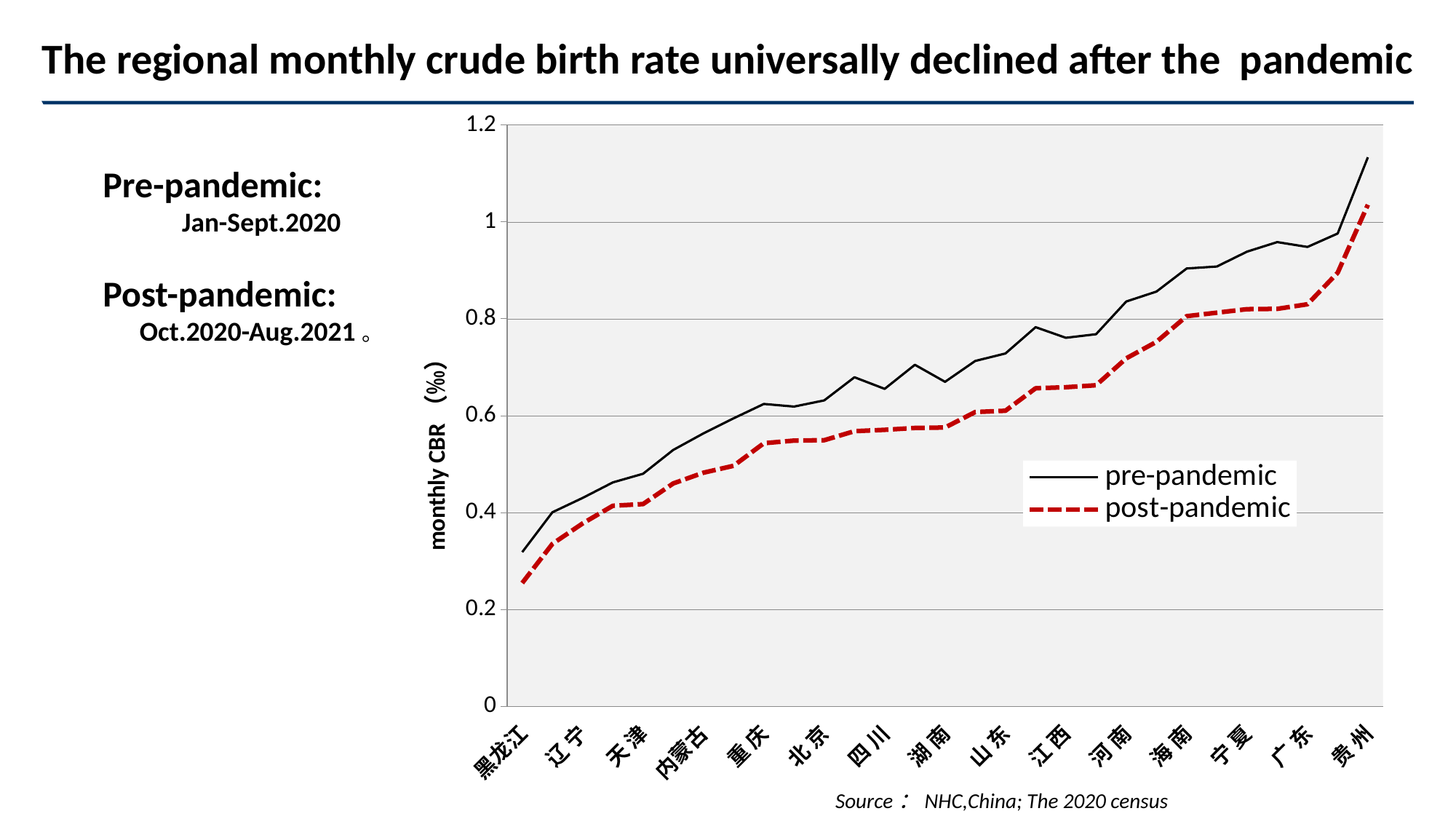
Which region has the lowest post-pandemic monthly CBR? 黑龙江 Is the pre-pandemic value for 贵州 greater or less than 1? greater Is the pre-pandemic value for 黑龙江 greater or less than 0.4? less What kind of chart is shown on the slide? line chart For 北京, which is larger: the pre-pandemic or the post-pandemic monthly CBR? pre-pandemic How many region labels are shown along the x axis? 15 Which region has the highest pre-pandemic monthly CBR? 贵州 How many series does the legend list? 2 Is the post-pandemic value for 北京 greater or less than 0.6? less Which series is drawn as a red dashed line? post-pandemic Do the values of the pre-pandemic series generally rise or fall from left to right along the x axis? rise What are the two series named in the legend? pre-pandemic and post-pandemic